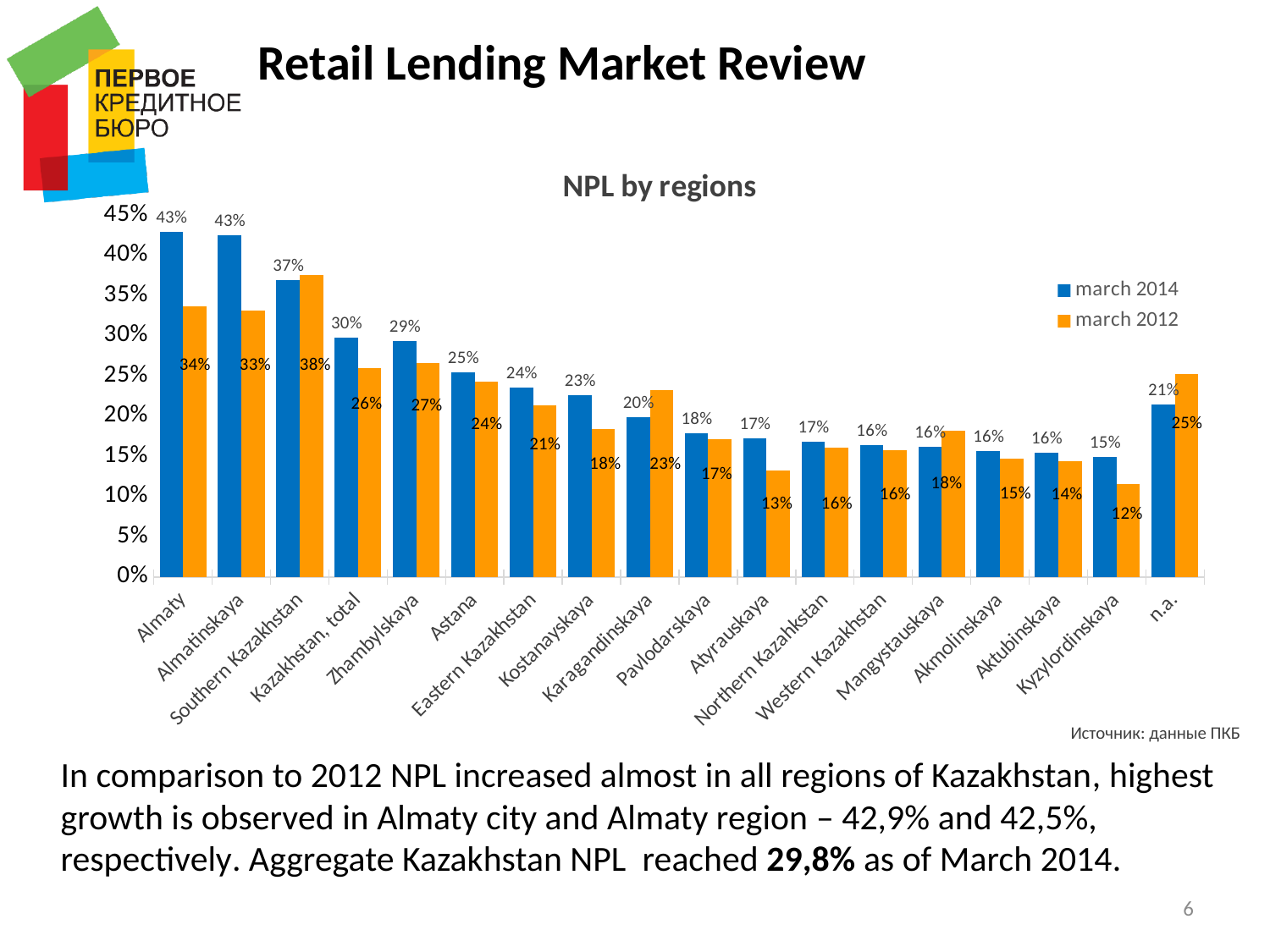
Which region has the highest march 2012 value? Southern Kazakhstan What is the march 2014 value for Kazakhstan, total? 30% What is the NPL value for Southern Kazakhstan in march 2012? 38% How many regions (categories) are shown on the x axis? 18 What is the NPL value for Almaty in march 2014? 43% For Karagandinskaya, which series has the larger value, march 2014 or march 2012? march 2012 What is the title of the chart? NPL by regions By how many percentage points does the march 2014 value for Almaty exceed its march 2012 value? 9 percentage points What kind of chart is shown on the slide? Bar chart How many series does the legend list? 2 What is the march 2012 value for Atyrauskaya? 13% Which region has the lowest march 2012 value? Kyzylordinskaya